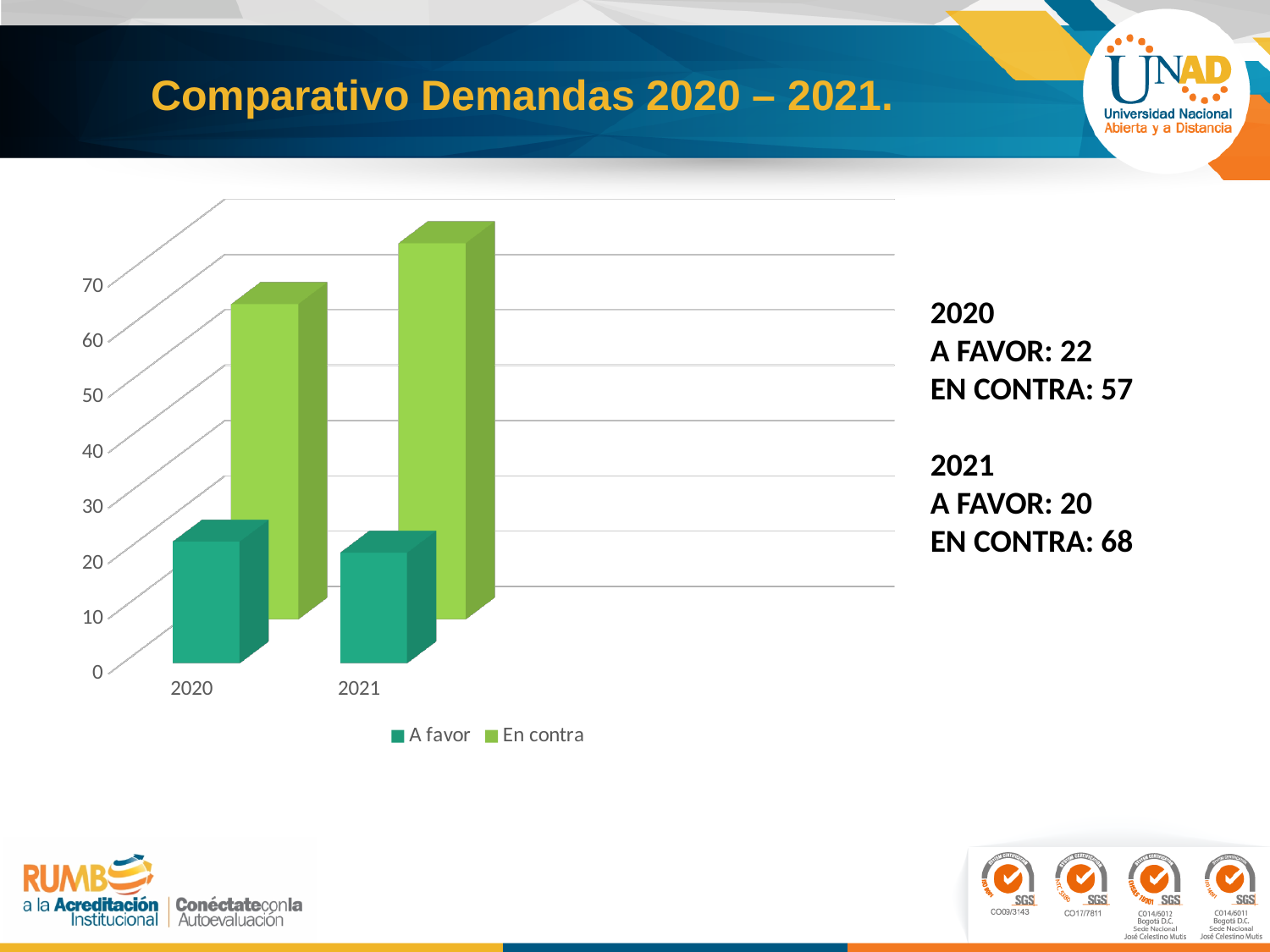
What is the difference between 'En contra' and 'A favor' in 2021? 48 What is the value of 'En contra' for 2021? 68 What kind of chart is shown on the slide? bar chart What is the title of the slide containing the chart? Comparativo Demandas 2020 – 2021. What is the value of 'A favor' for 2020? 22 How many categories are shown on the x axis of the chart? 2 Does the 'En contra' series rise or fall from 2020 to 2021? rise Is the 'En contra' value for 2020 greater or less than 50? greater How many series does the chart legend list? 2 What is the value of 'En contra' for 2020? 57 Which year has the higher 'En contra' value? 2021 What is the value of 'A favor' for 2021? 20